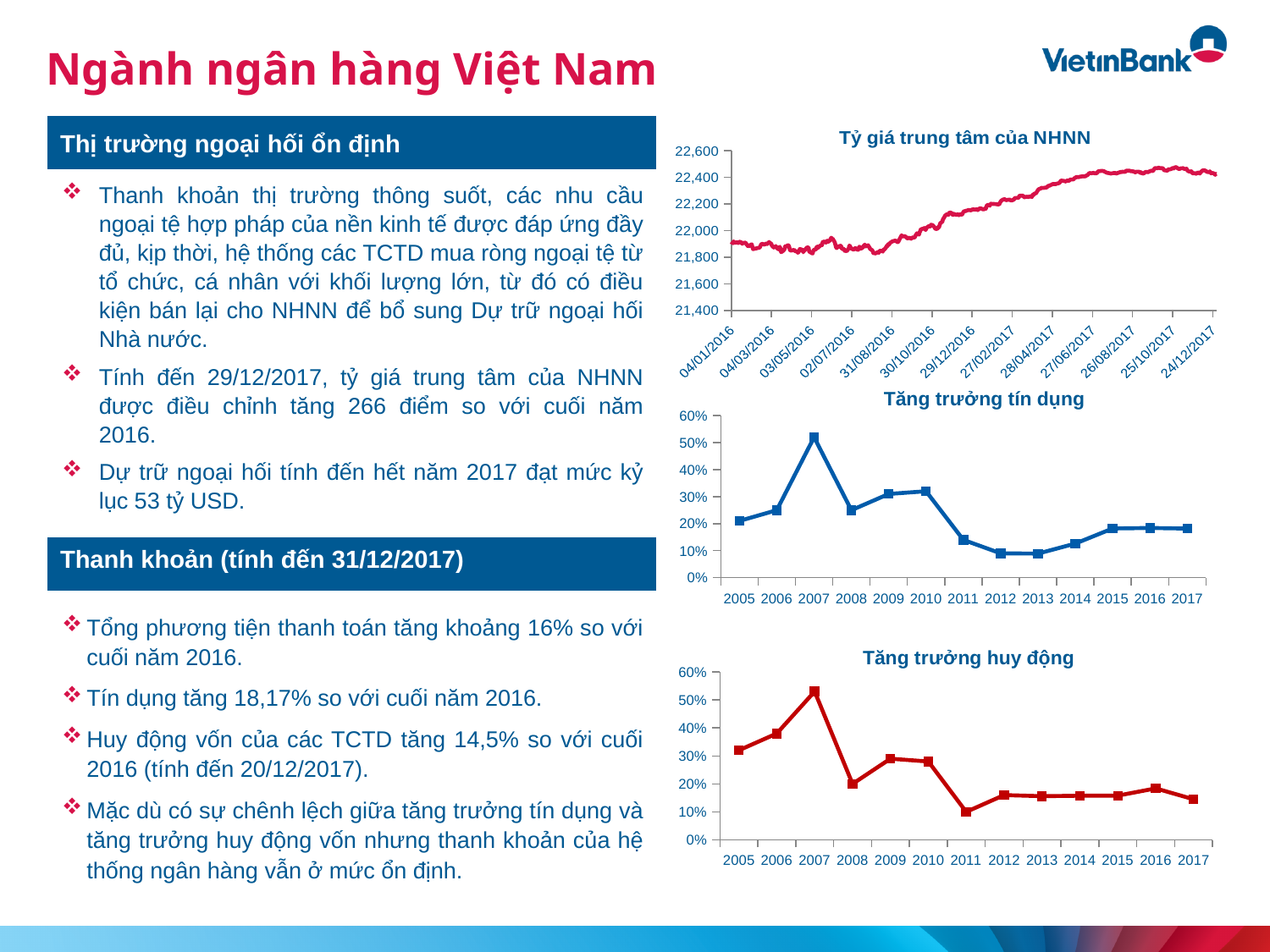
How many years are shown on the x axis of the "Tăng trưởng tín dụng" chart? 13 In the "Tăng trưởng tín dụng" chart, is the value for 2007 greater or less than 50%? greater In the "Tăng trưởng tín dụng" chart, which year has the highest credit growth? 2007 In the "Tăng trưởng tín dụng" chart, which is larger, the value for 2007 or the value for 2008? 2007 In the "Tăng trưởng huy động" chart, is the value for 2006 greater or less than 30%? greater In the "Tỷ giá trung tâm của NHNN" chart, is the value at 24/12/2017 greater or less than 22,200? greater What kind of chart is the "Tăng trưởng tín dụng" chart? Line chart In the "Tỷ giá trung tâm của NHNN" chart, do the values generally rise or fall from the start of 2016 to the end of 2017? Rise In the "Tăng trưởng huy động" chart, which year has the highest value? 2007 In the "Tăng trưởng huy động" chart, which year has the lowest value? 2011